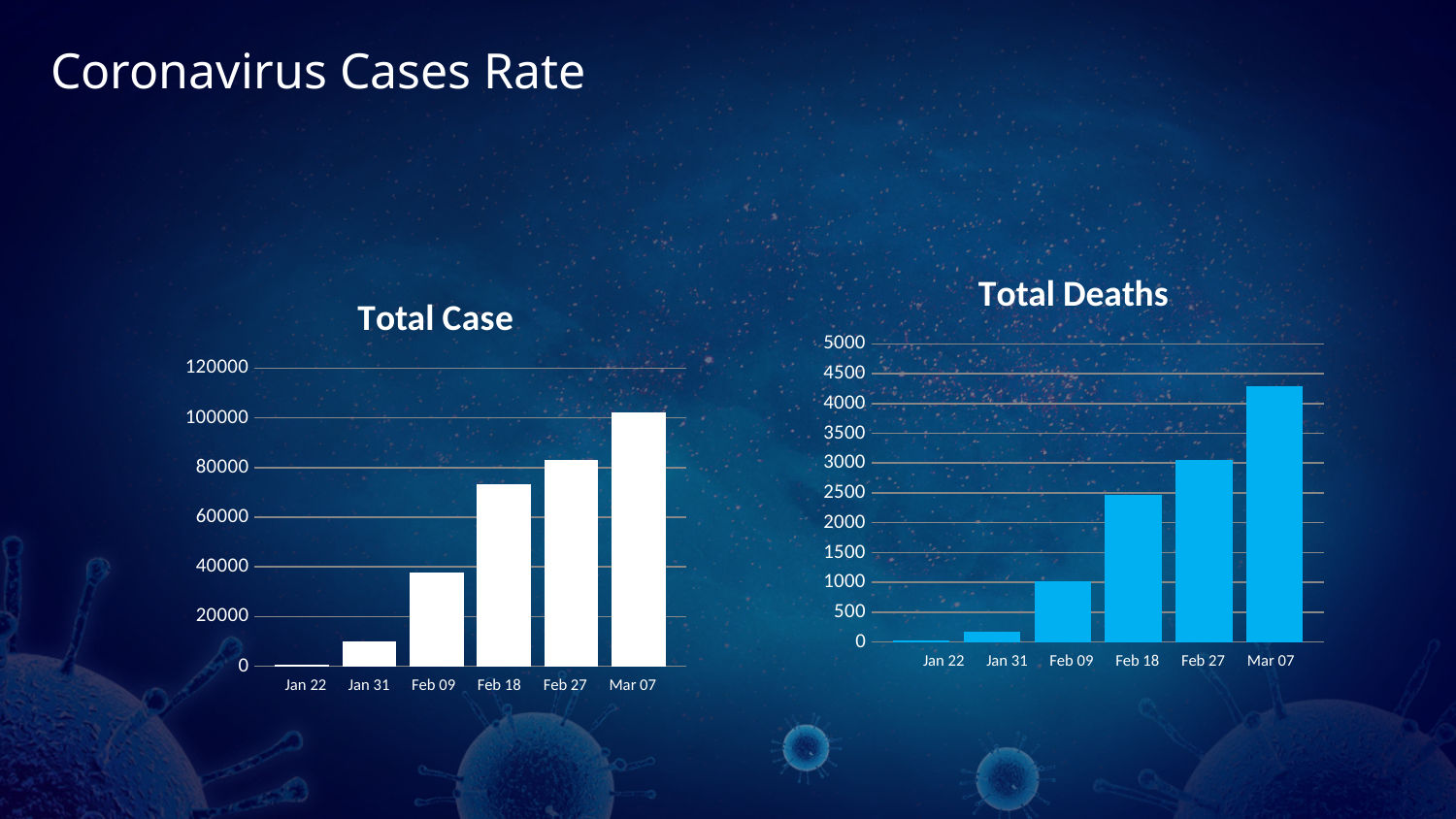
In the Total Deaths chart, which date has the highest value? Mar 07 In the Total Case chart, which date has the highest total? Mar 07 In the Total Case chart, is the value for Feb 18 greater or less than 60000? greater What kind of chart is the Total Case chart? bar chart In the Total Deaths chart, is the value for Feb 27 greater or less than 2500? greater In the Total Case chart, which date has the lowest total? Jan 22 In the Total Case chart, which is larger, the value for Feb 18 or Feb 27? Feb 27 In the Total Deaths chart, which date has the lowest value? Jan 22 In the Total Deaths chart, do the values rise or fall from Jan 22 to Mar 07? rise How many dates are shown on the x axis of the Total Deaths chart? 6 In the Total Deaths chart, is the value for Mar 07 greater or less than 4000? greater